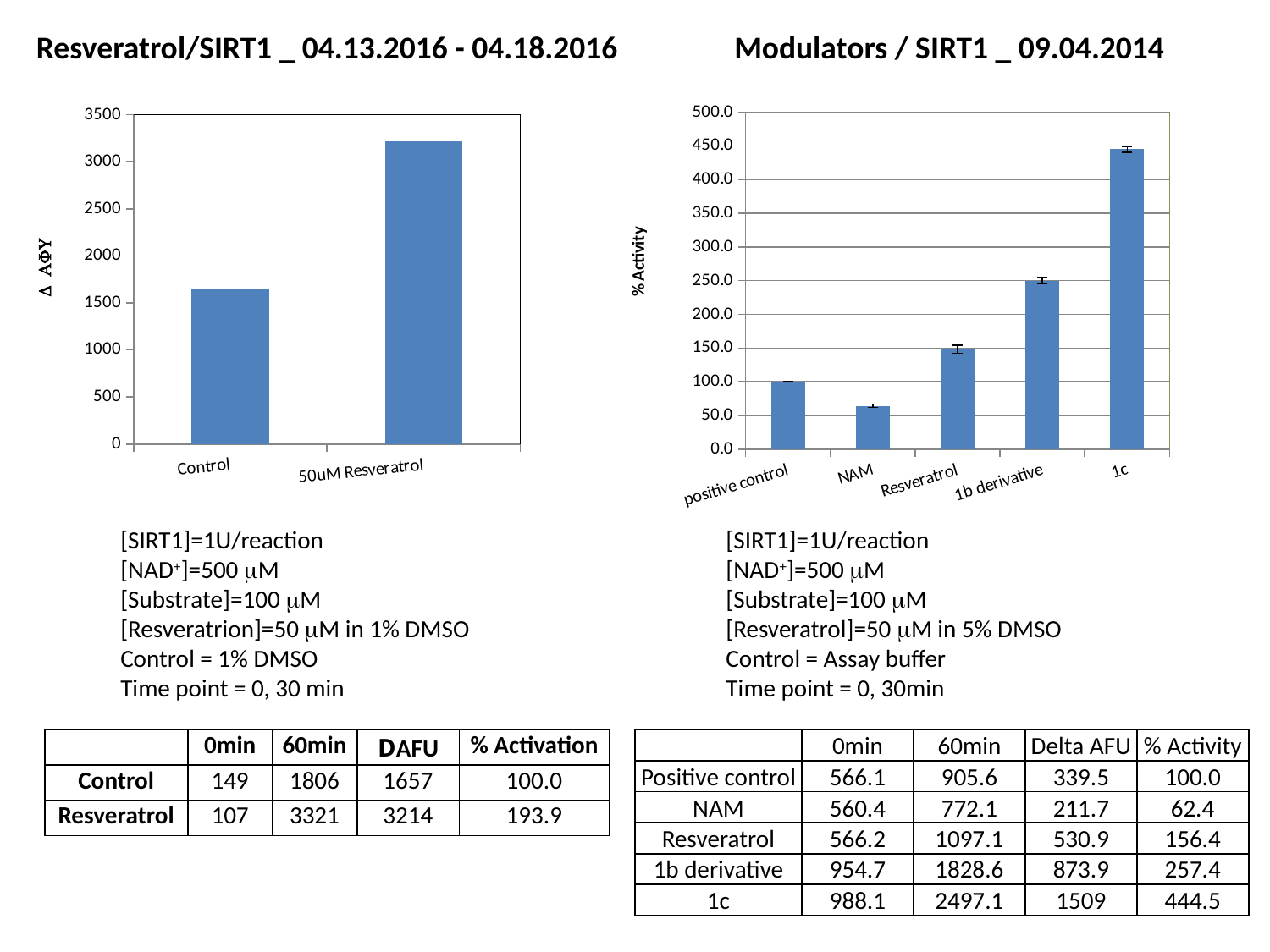
What kind of chart is the left chart titled "Resveratrol/SIRT1 _ 04.13.2016 - 04.18.2016"? bar chart In the left chart (Resveratrol/SIRT1), which category has the highest value? 50uM Resveratrol How many categories are plotted in the left chart (Resveratrol/SIRT1)? 2 How many categories are plotted in the right chart titled "Modulators / SIRT1 _ 09.04.2014"? 5 In the right chart (Modulators / SIRT1), which category has the highest % Activity? 1c In the right chart (Modulators / SIRT1), is the value for 1c greater or less than 400.0? greater In the right chart (Modulators / SIRT1), is the value for NAM greater or less than 100.0? less In the left chart (Resveratrol/SIRT1), is the value for 50uM Resveratrol greater or less than 3000? greater In the left chart (Resveratrol/SIRT1), which is larger, the value for Control or for 50uM Resveratrol? 50uM Resveratrol In the right chart (Modulators / SIRT1), which category has the lowest % Activity? NAM What is the label of the y axis in the right chart (Modulators / SIRT1)? % Activity